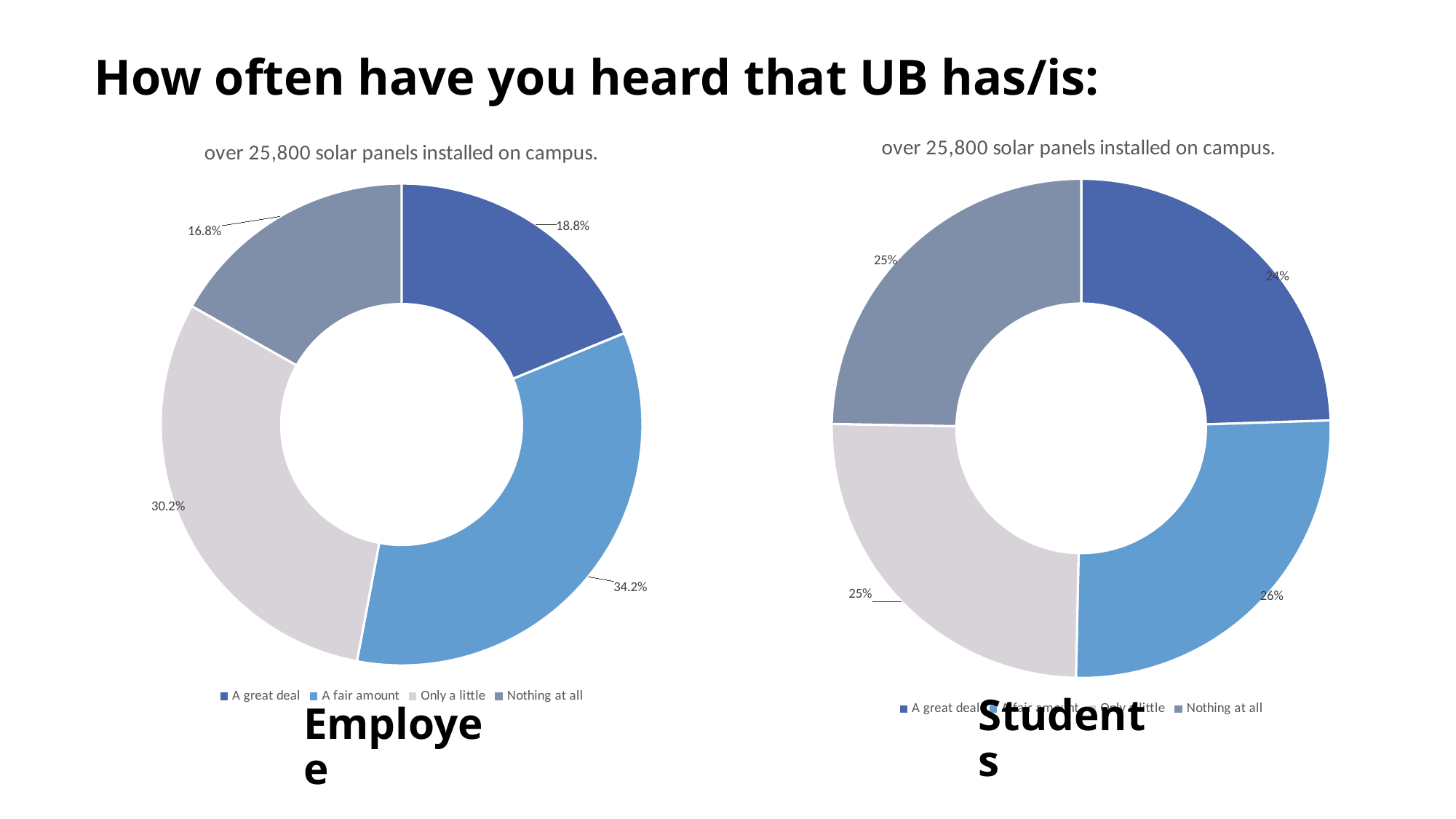
In the Employee chart, what percentage of respondents answered 'Nothing at all'? 16.8% What kind of chart is used for the Employee data? Doughnut chart In the Students chart, what percentage of respondents answered 'A fair amount'? 26% In the Employee chart, what percentage of respondents answered 'A fair amount'? 34.2% In the Students chart, which response category has the smallest share? A great deal In the Employee chart, which is larger: the share for 'A great deal' or the share for 'Only a little'? Only a little In the Students chart, what percentage of respondents answered 'A great deal'? 24% What is the title shown above the Students chart? over 25,800 solar panels installed on campus. In the Employee chart, which response category has the largest share? A fair amount How many response categories does the legend of the Students chart list? 4 In the Employee chart, which response category has the smallest share? Nothing at all In the Employee chart, what is the difference in percentage points between 'A fair amount' and 'Only a little'? 4 percentage points